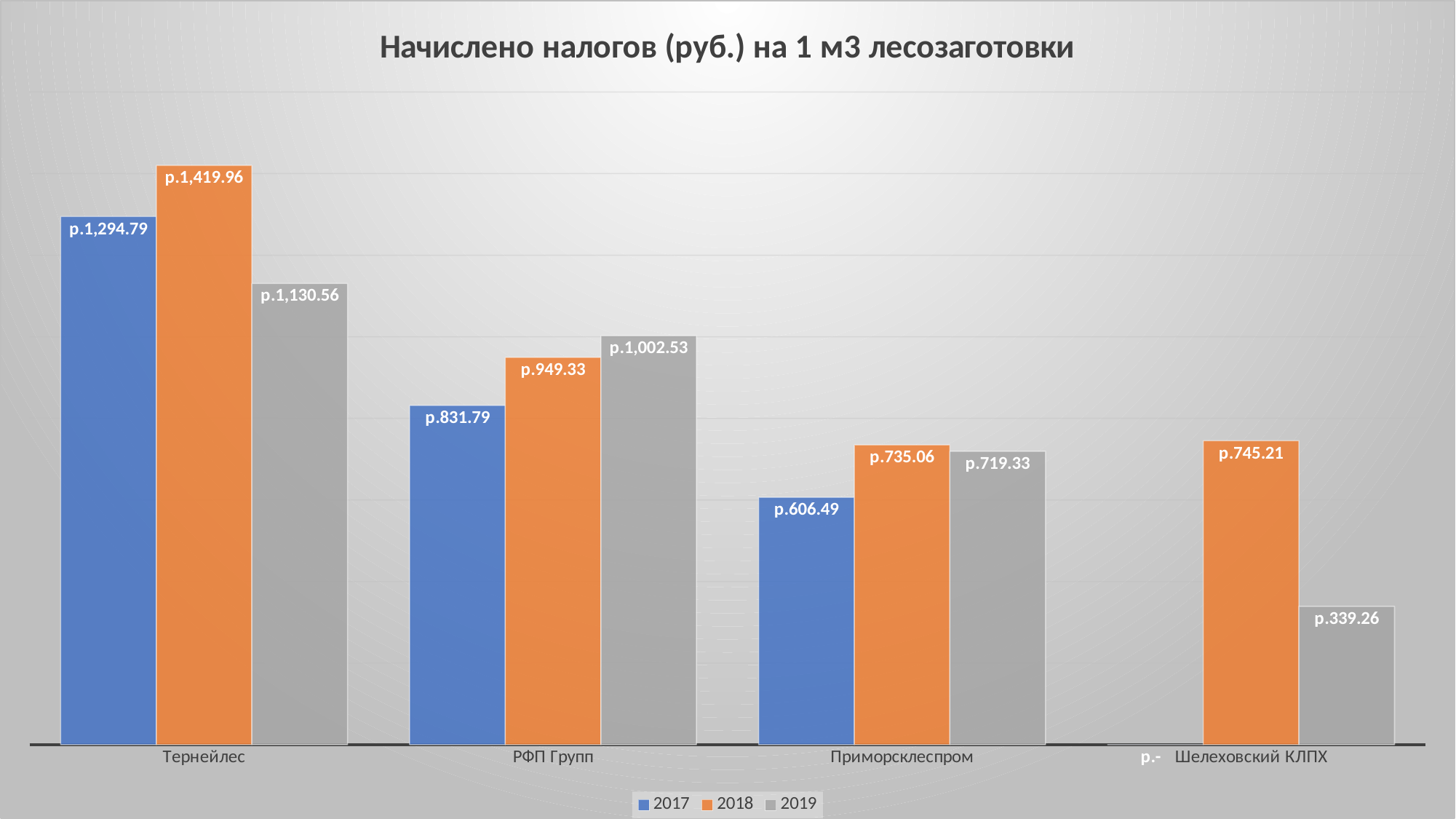
What is the difference between the 2018 and 2019 values for Шелеховский КЛПХ? р.405.95 What is the 2019 value for Шелеховский КЛПХ? р.339.26 Which category has the lowest 2019 value? Шелеховский КЛПХ For Приморсклеспром, which is larger: the 2018 value or the 2019 value? 2018 What is the 2017 value for Приморсклеспром? р.606.49 How many categories are shown on the x axis? 4 How many series does the legend list? 3 What kind of chart is this? Bar chart Which category has the highest 2018 value? Тернейлес What is the 2018 value for Тернейлес? р.1,419.96 What is the 2019 value for РФП Групп? р.1,002.53 What is the difference between the 2018 and 2017 values for Тернейлес? р.125.17